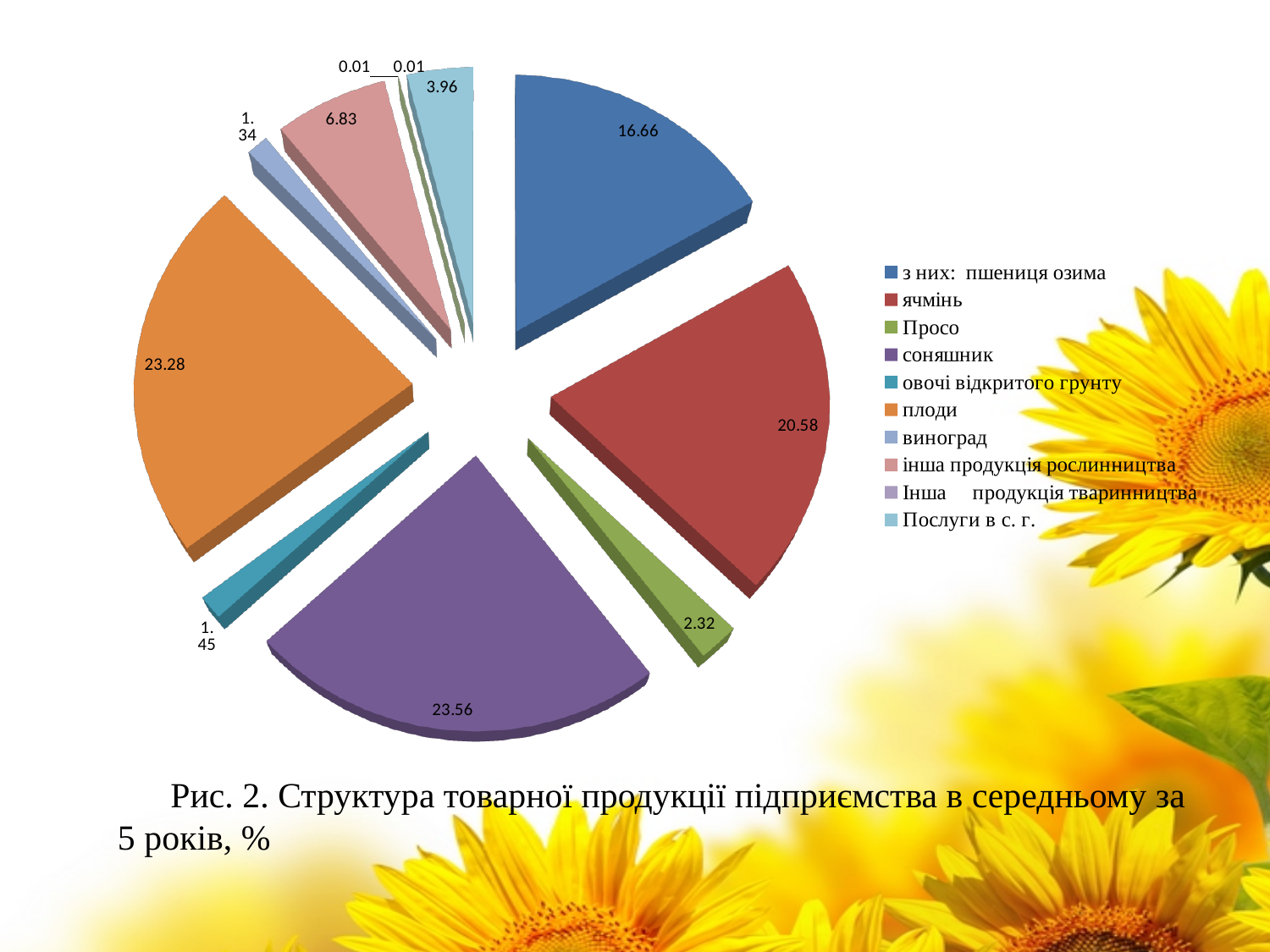
What is the value for соняшник? 23.56 What is the difference between the values for ячмінь and з них: пшениця озима? 3.92 What is the value for ячмінь? 20.58 Which is larger, ячмінь or з них: пшениця озима? ячмінь What is the value for плоди? 23.28 What is the value for інша продукція рослинництва? 6.83 What is the value for з них: пшениця озима? 16.66 What is the value for Просо? 2.32 How many entries does the legend list? 10 What is the value for Послуги в с. г.? 3.96 What kind of chart is shown on the slide? pie chart Which category has the largest slice? соняшник